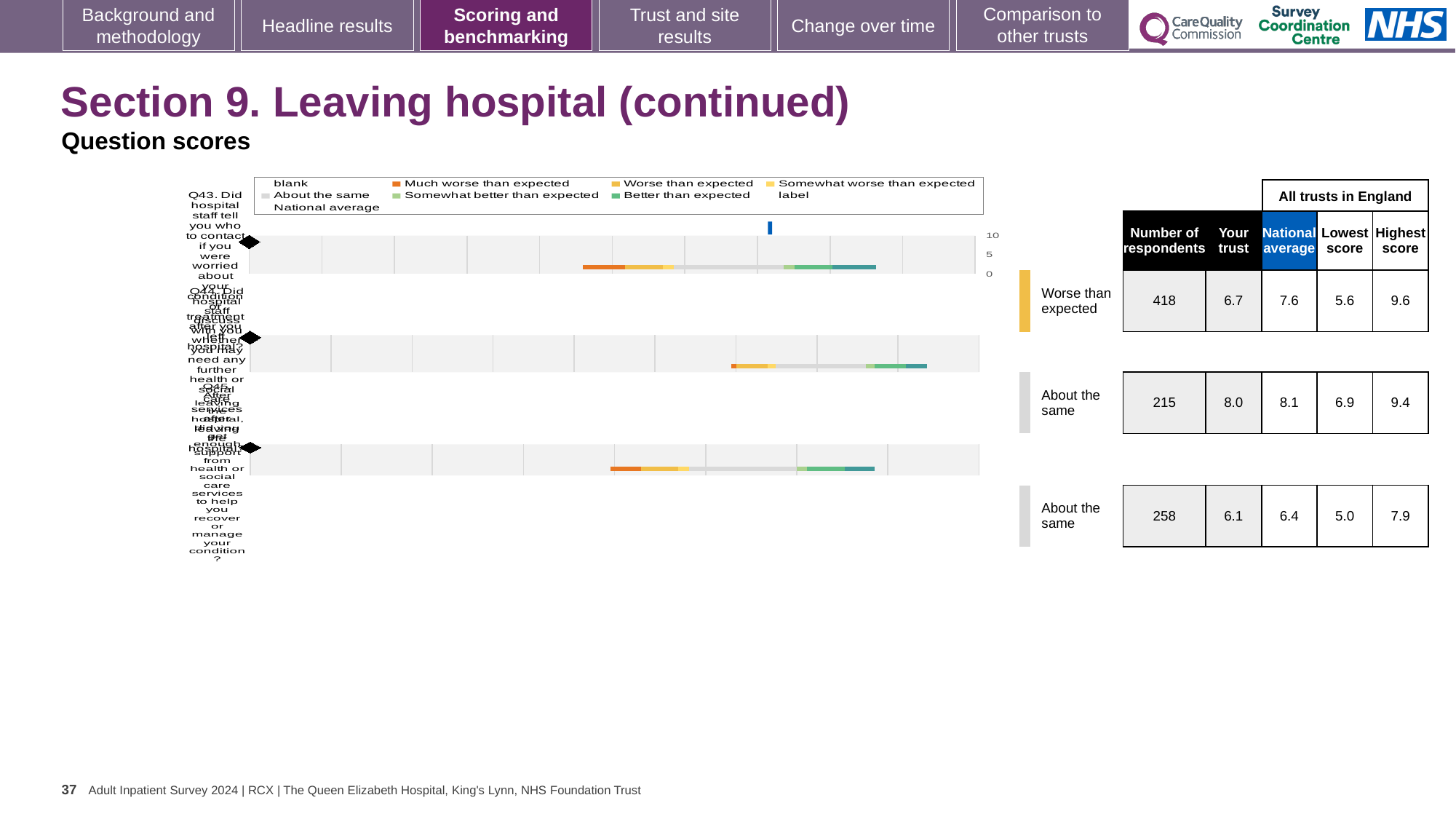
For the first row (Q43), what is the national average score? 7.6 For the second row ('About the same', 215 respondents), what is the highest score among all trusts in England? 9.4 For the third row (258 respondents), which is larger: the 'Your trust' score or the national average? National average For the first row (Q43), how many respondents are there? 418 For the first row (Q43), what is the difference between the national average and the 'Your trust' score? 0.9 Which row has the highest 'Your trust' score? The second row (8.0) For the first row (Q43, 'Worse than expected'), what is the 'Your trust' score? 6.7 How many question rows (charts) are shown on the slide? 3 What kind of chart is used for the question scores on this slide? bar chart For the third row ('About the same', 258 respondents), what is the lowest score among all trusts in England? 5.0 What is the benchmark category shown for the first row (Q43)? Worse than expected Which row has the lowest 'Your trust' score? The third row (6.1)